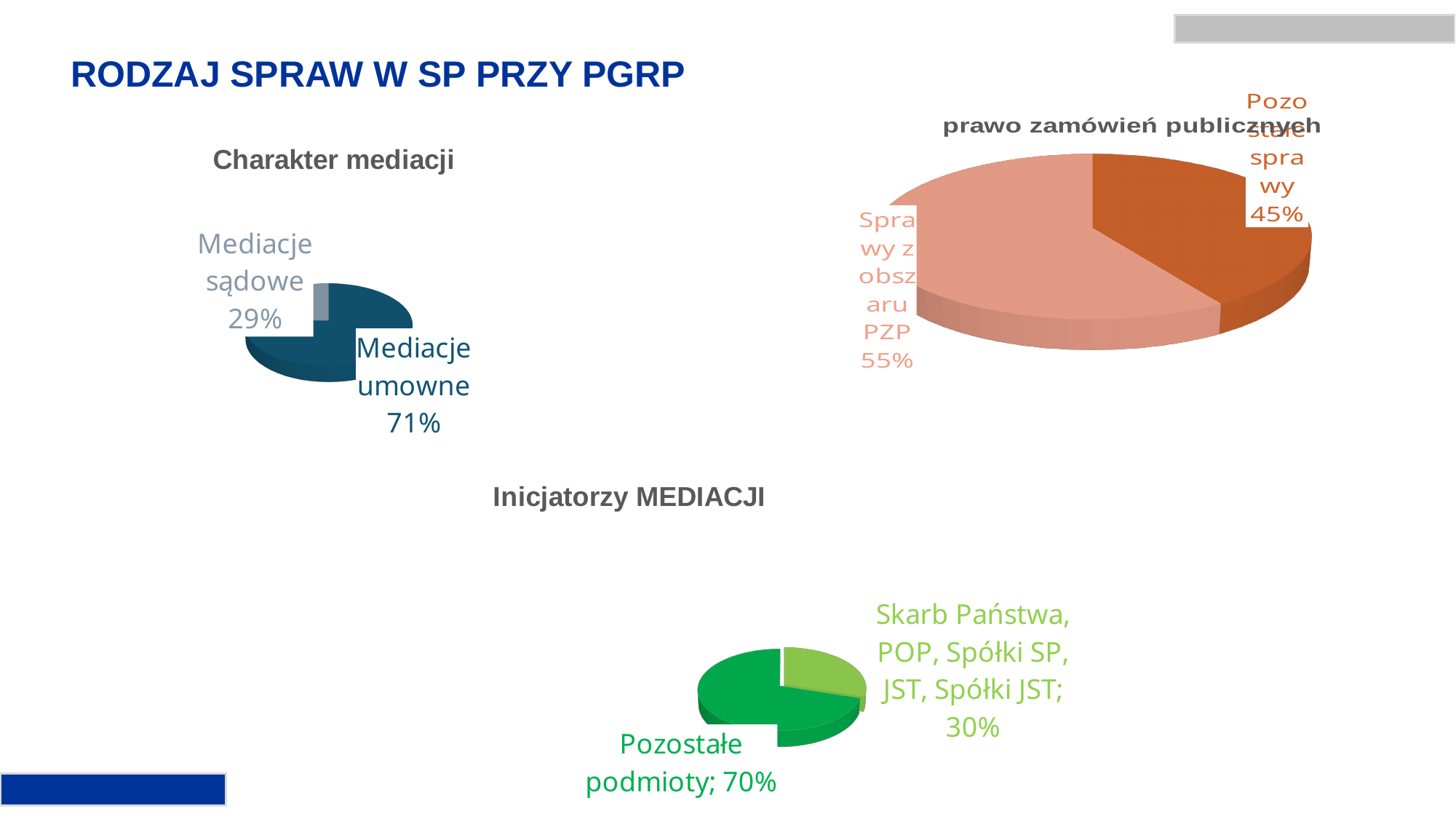
In the 'Inicjatorzy MEDIACJI' chart, what share is labelled for 'Pozostałe podmioty'? 70% In the 'prawo zamówień publicznych' chart, what share is labelled for 'Pozostałe sprawy'? 45% How many slices does the 'prawo zamówień publicznych' chart have? 2 In the 'prawo zamówień publicznych' chart, what share is labelled for 'Sprawy z obszaru PZP'? 55% In the 'Charakter mediacji' chart, what share is labelled for 'Mediacje sądowe'? 29% In the 'prawo zamówień publicznych' chart, which slice is smaller? Pozostałe sprawy What kind of chart is the 'Charakter mediacji' chart? Pie chart In the 'Inicjatorzy MEDIACJI' chart, which slice is larger: 'Pozostałe podmioty' or 'Skarb Państwa, POP, Spółki SP, JST, Spółki JST'? Pozostałe podmioty In the 'Charakter mediacji' chart, which slice is the largest? Mediacje umowne In the 'Inicjatorzy MEDIACJI' chart, what share is labelled for 'Skarb Państwa, POP, Spółki SP, JST, Spółki JST'? 30% In the 'Charakter mediacji' chart, what is the difference in percentage points between 'Mediacje umowne' and 'Mediacje sądowe'? 42 In the 'Charakter mediacji' chart, what share is labelled for 'Mediacje umowne'? 71%